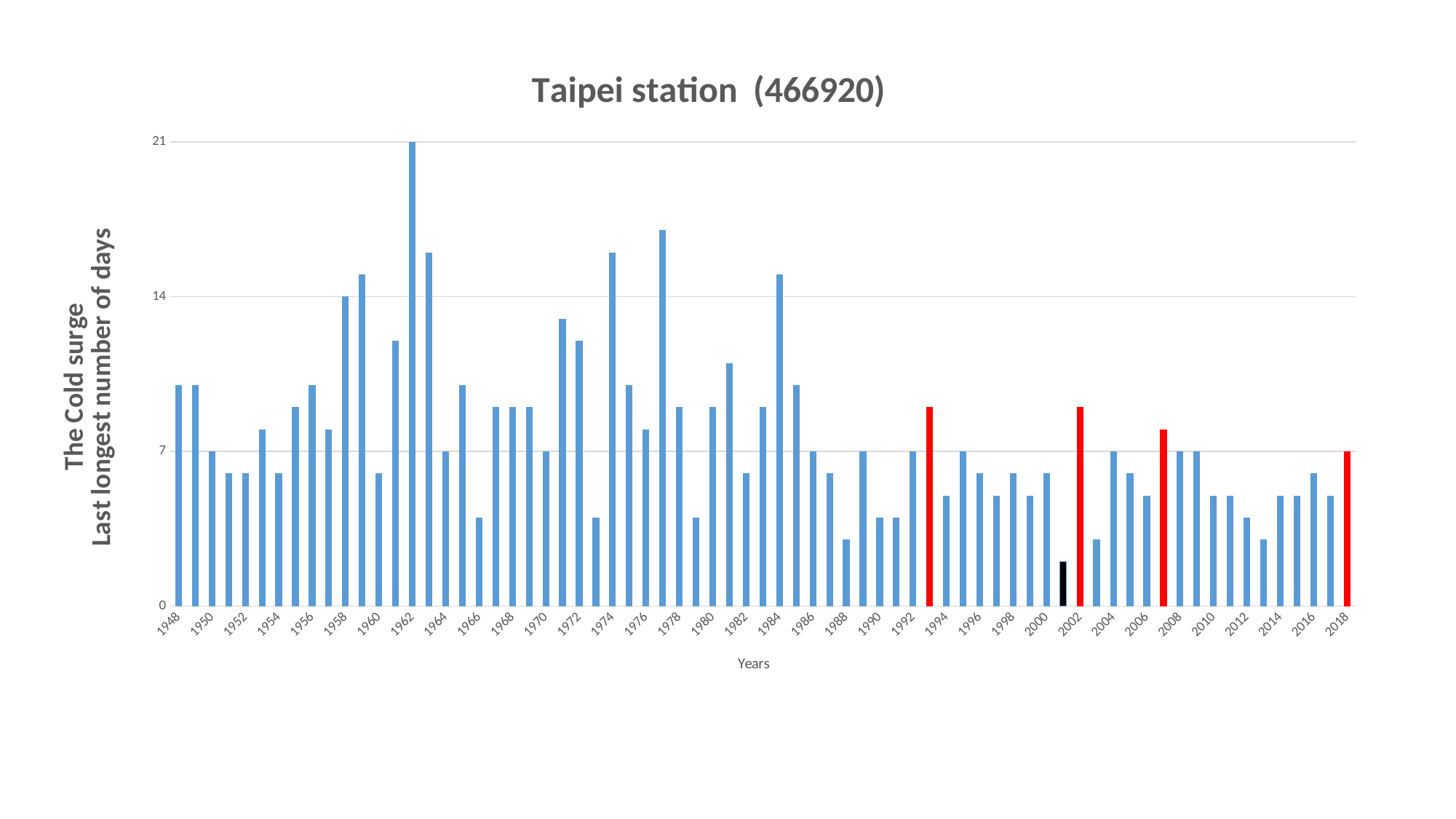
What is the label on the x axis? Years What is the value for 1958? 14 Which year has the highest value in the chart? 1962 Which is larger, the value for 1962 or the value for 1977? 1962 Which year has the lowest value in the chart? 2001 Is the value for 1988 greater or less than 7? less What is the value for 2018? 7 What is the value for 1962? 21 What is the title of the chart? Taipei station (466920) Is the value for 2002 greater or less than 7? greater What kind of chart is shown on the slide? bar chart Is the value for 1977 greater or less than 14? greater